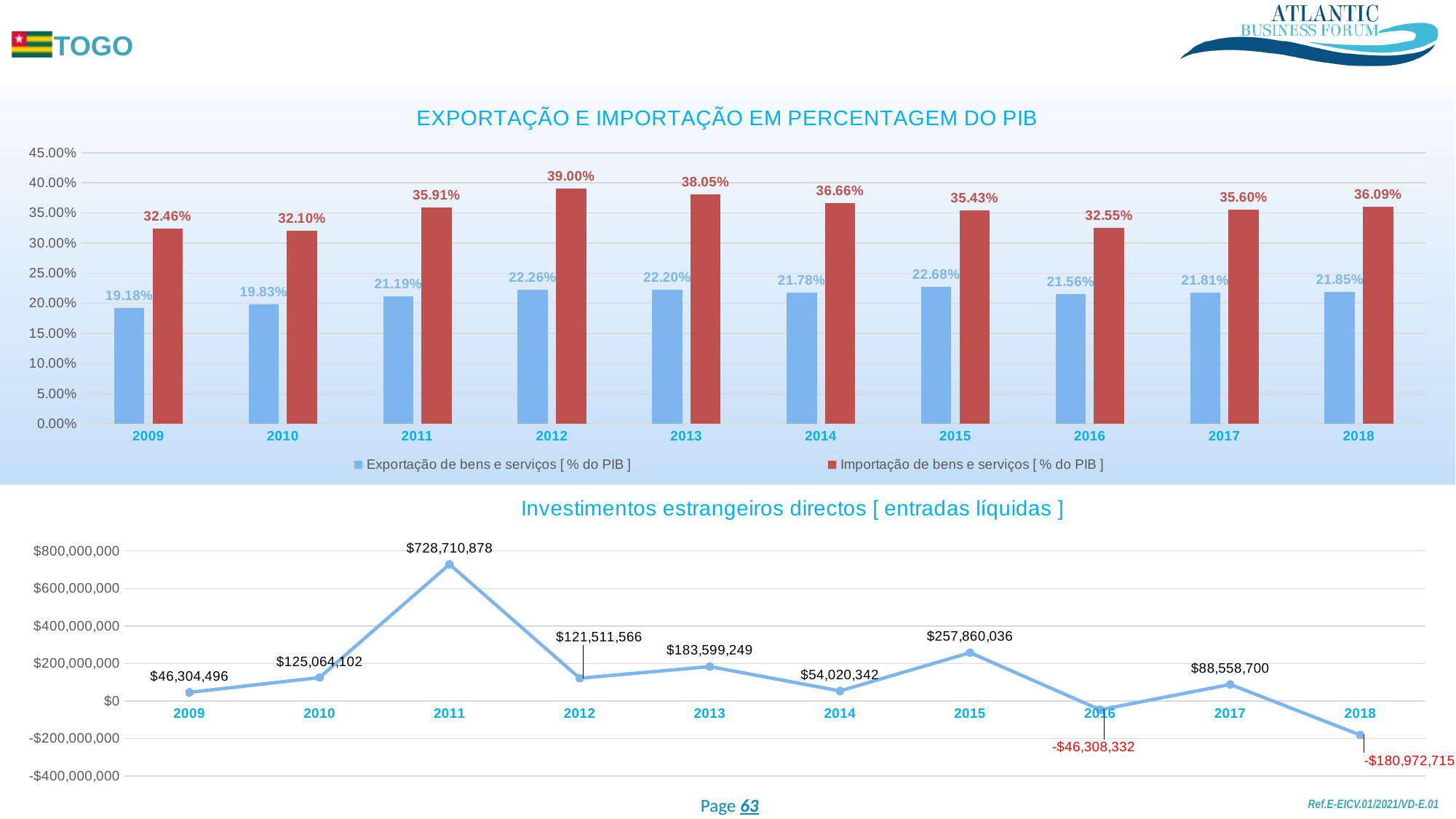
In the chart 'EXPORTAÇÃO E IMPORTAÇÃO EM PERCENTAGEM DO PIB', how many series does the legend list? 2 In the chart 'Investimentos estrangeiros directos [ entradas líquidas ]', which year has the lowest value? 2018 In the chart 'Investimentos estrangeiros directos [ entradas líquidas ]', is the value for 2015 larger than the value for 2013? Yes In the chart 'EXPORTAÇÃO E IMPORTAÇÃO EM PERCENTAGEM DO PIB', which year has the highest Importação de bens e serviços value? 2012 In the chart 'EXPORTAÇÃO E IMPORTAÇÃO EM PERCENTAGEM DO PIB', what is the value of Exportação de bens e serviços for 2015? 22.68% In the chart 'Investimentos estrangeiros directos [ entradas líquidas ]', what is the value for 2011? $728,710,878 In the chart 'EXPORTAÇÃO E IMPORTAÇÃO EM PERCENTAGEM DO PIB', what is the difference between Importação and Exportação in 2018? 14.24% In the chart 'Investimentos estrangeiros directos [ entradas líquidas ]', what is the value for 2018? -$180,972,715 In the chart 'EXPORTAÇÃO E IMPORTAÇÃO EM PERCENTAGEM DO PIB', which year has the lowest Exportação de bens e serviços value? 2009 In the chart 'EXPORTAÇÃO E IMPORTAÇÃO EM PERCENTAGEM DO PIB', what is the value of Importação de bens e serviços for 2012? 39.00% What kind of chart is 'EXPORTAÇÃO E IMPORTAÇÃO EM PERCENTAGEM DO PIB'? Bar chart How many years are plotted in the chart 'Investimentos estrangeiros directos [ entradas líquidas ]'? 10